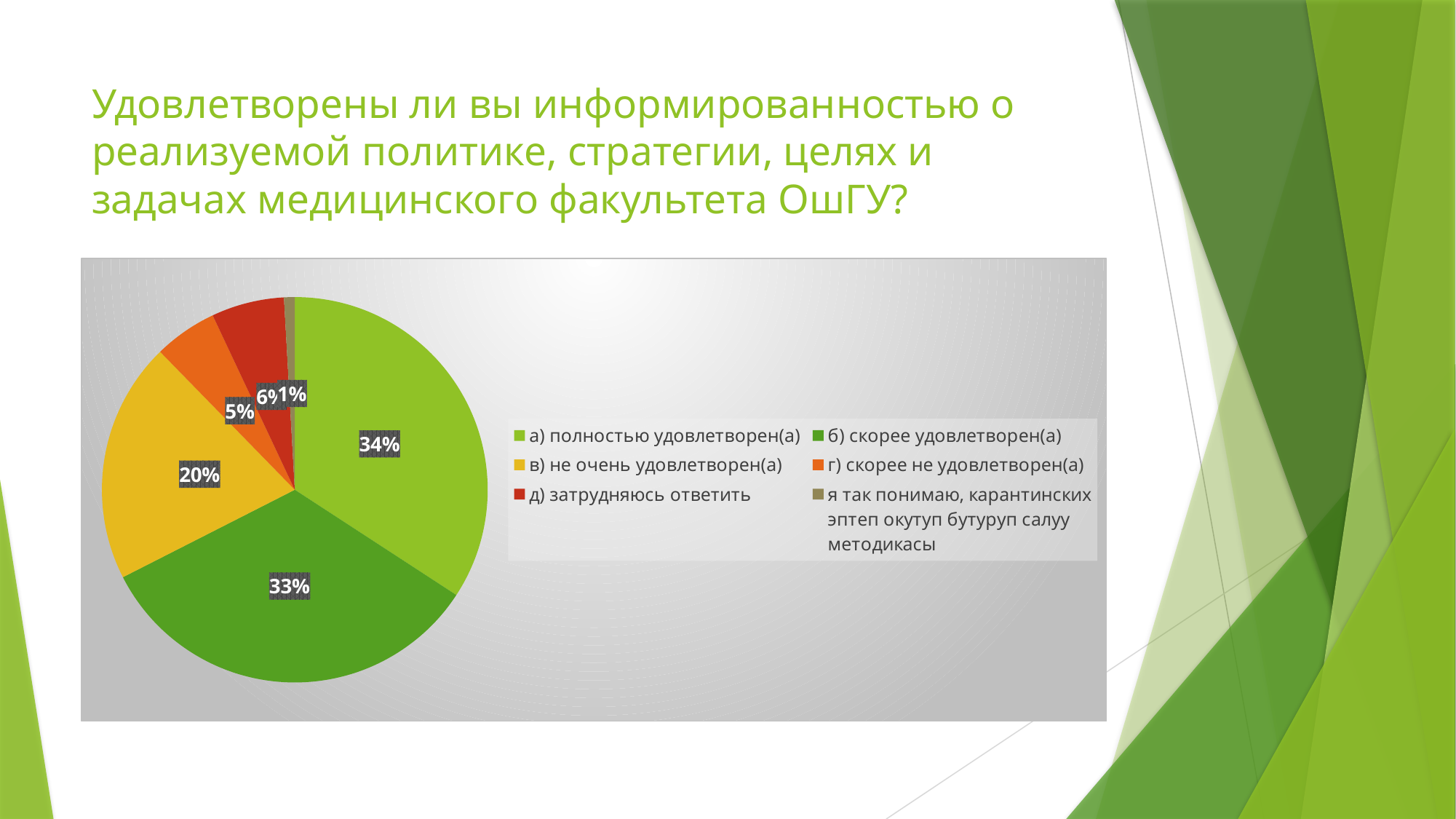
What share of respondents answered "в) не очень удовлетворен(а)"? 20% What share of respondents answered "а) полностью удовлетворен(а)"? 34% What colour is the slice for "в) не очень удовлетворен(а)"? yellow Which is larger: the share for "д) затрудняюсь ответить" or the share for "г) скорее не удовлетворен(а)"? д) затрудняюсь ответить What share of respondents answered "г) скорее не удовлетворен(а)"? 5% What share of respondents answered "б) скорее удовлетворен(а)"? 33% What share of respondents answered "д) затрудняюсь ответить"? 6% What kind of chart is shown on the slide? pie chart Which answer option has the smallest share of the pie? я так понимаю, карантинских эптеп окутуп бутуруп салуу методикасы What is the difference between the shares for "а) полностью удовлетворен(а)" and "в) не очень удовлетворен(а)"? 14% Which answer option has the largest share of the pie? а) полностью удовлетворен(а) How many slices does the pie chart have? 6